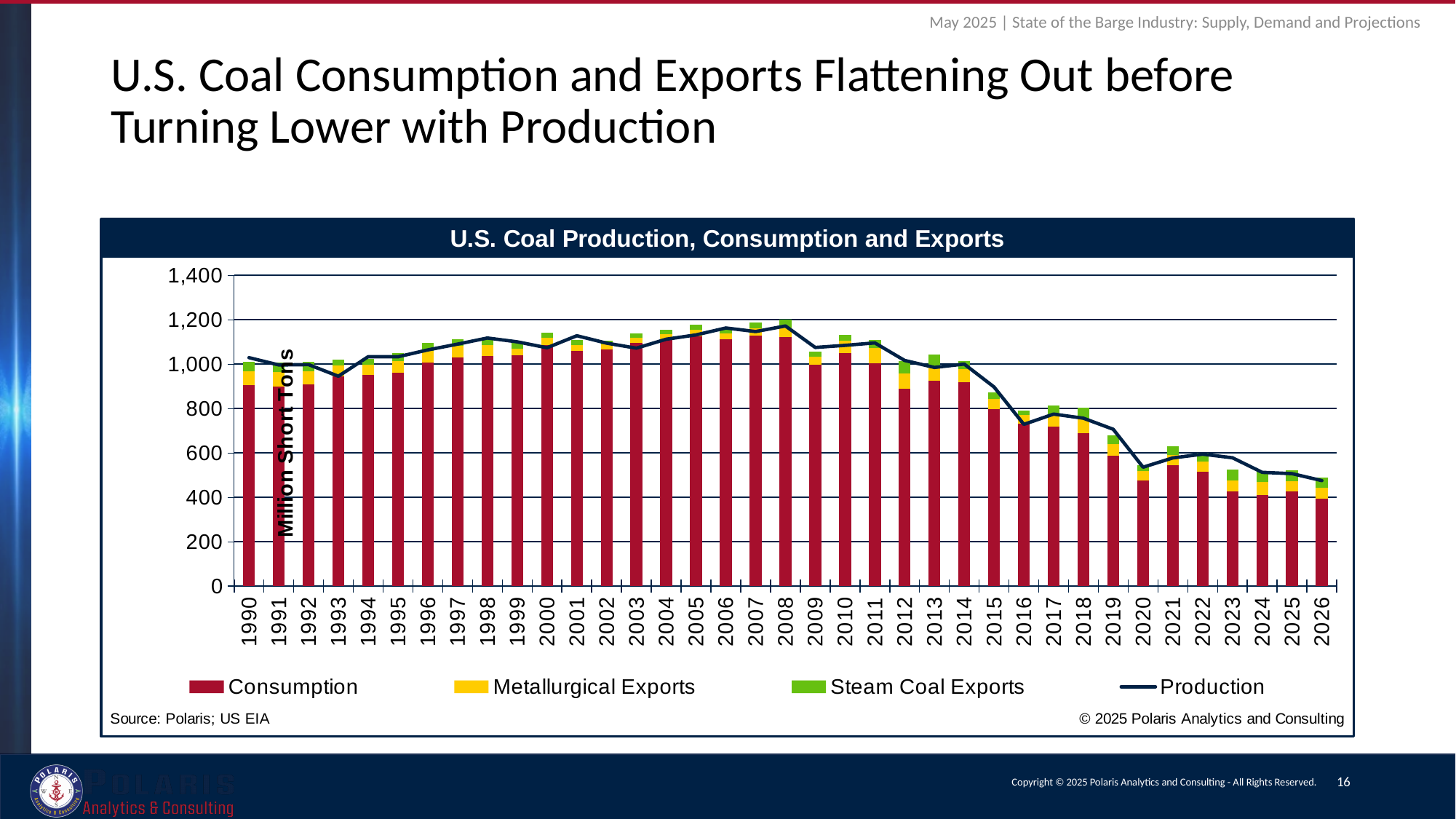
Does Consumption rise or fall from 2008 to 2026? fall What kind of chart is shown on the slide? Bar chart with a line What is the label on the y axis? Million Short Tons Is the Production value for 2008 greater or less than 1,000? greater How many series does the legend list? 4 How many years are shown on the x axis? 37 Which is larger, Consumption in 2000 or Consumption in 2020? 2000 Is the Consumption value for 2020 greater or less than 600? less Is the Consumption value for 2005 greater or less than 1,000? greater Which is larger, Production in 2008 or Production in 2016? 2008